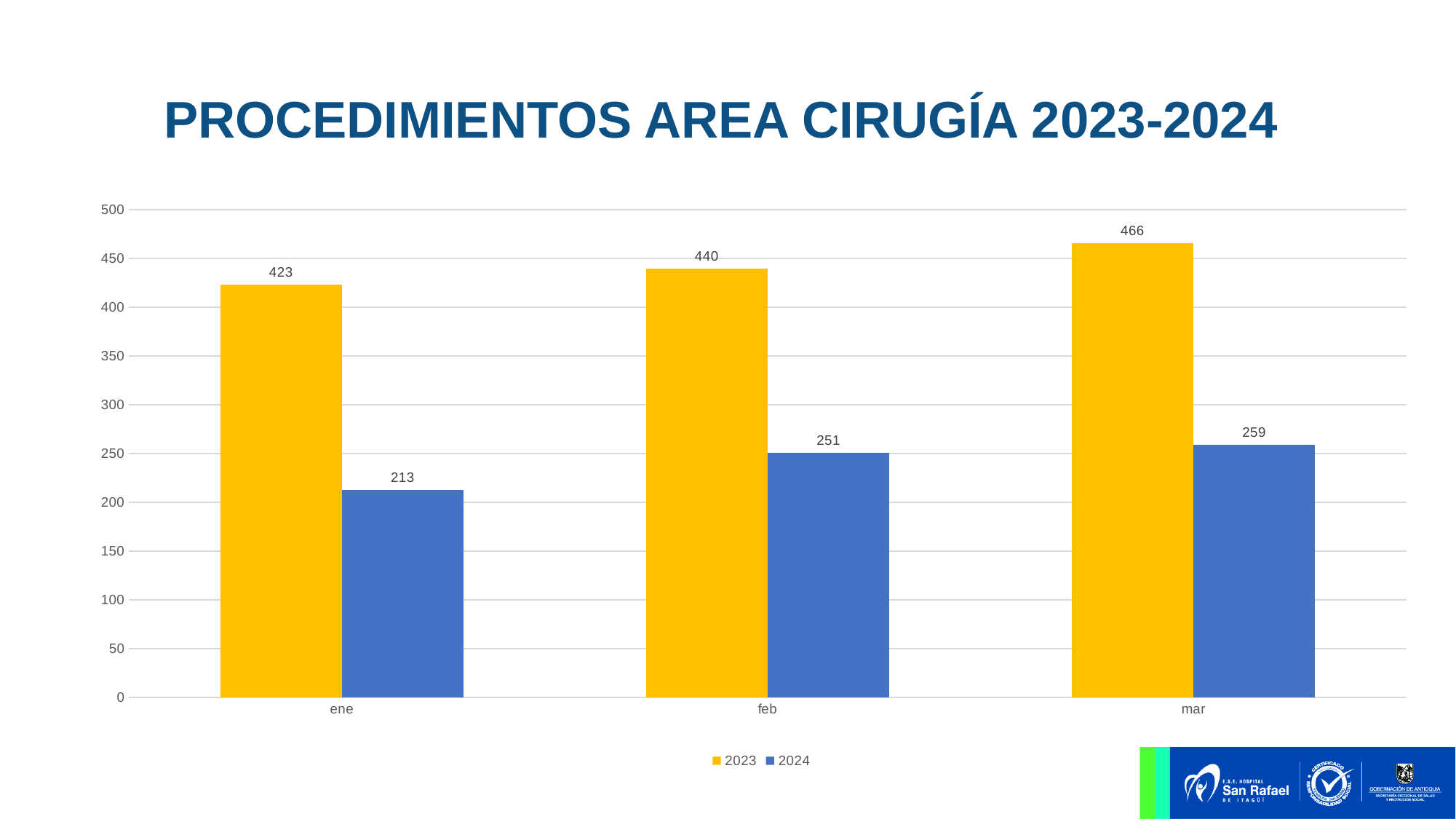
What is the value for 2024 in mar? 259 How many months are shown on the x axis? 3 What is the value for 2023 in feb? 440 Which is larger in feb, the 2023 value or the 2024 value? 2023 How many series does the legend list? 2 Is the value for 2024 in feb greater or less than 300? less What kind of chart is shown on the slide? bar chart Which month has the lowest value for the 2024 series? ene Which month has the highest value for the 2023 series? mar What is the difference between the 2023 and 2024 values in mar? 207 What is the value for 2024 in ene? 213 What is the difference between the 2023 values for feb and ene? 17